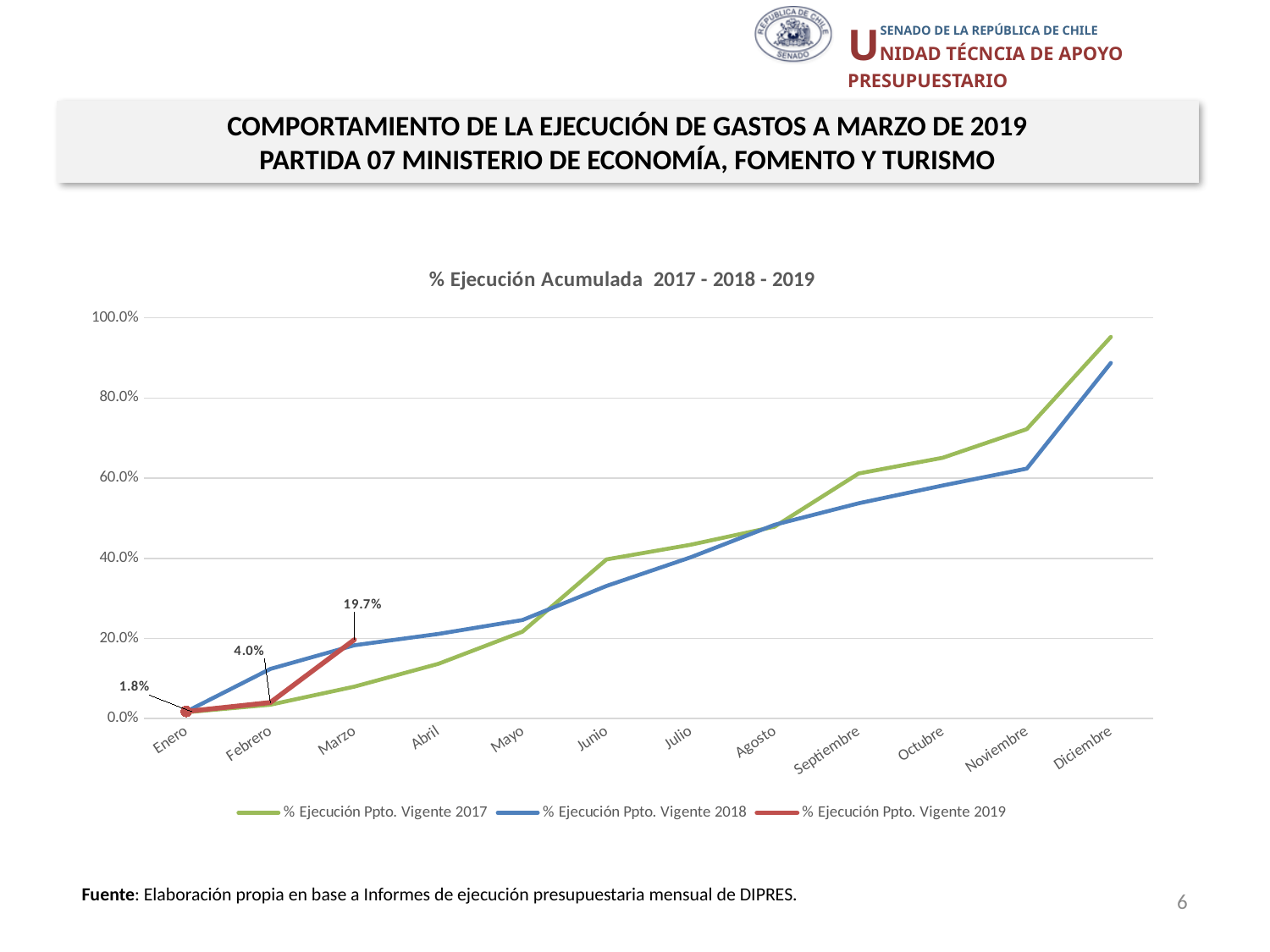
What is the difference between the 2019 values for Marzo and Febrero? 15.7% Which month has the highest value for the % Ejecución Ppto. Vigente 2019 series? Marzo What is the title of the chart? % Ejecución Acumulada 2017 - 2018 - 2019 Does the % Ejecución Ppto. Vigente 2017 series rise or fall from Enero to Diciembre? Rise In Diciembre, which series has the larger value, % Ejecución Ppto. Vigente 2017 or % Ejecución Ppto. Vigente 2018? % Ejecución Ppto. Vigente 2017 What is the value of % Ejecución Ppto. Vigente 2019 for Marzo? 19.7% How many months are shown on the x axis? 12 What is the value of % Ejecución Ppto. Vigente 2019 for Enero? 1.8% What is the value of % Ejecución Ppto. Vigente 2019 for Febrero? 4.0% Is the value for % Ejecución Ppto. Vigente 2018 in Junio greater or less than 40.0%? less What kind of chart is shown on the slide? Line chart How many series does the legend list? 3